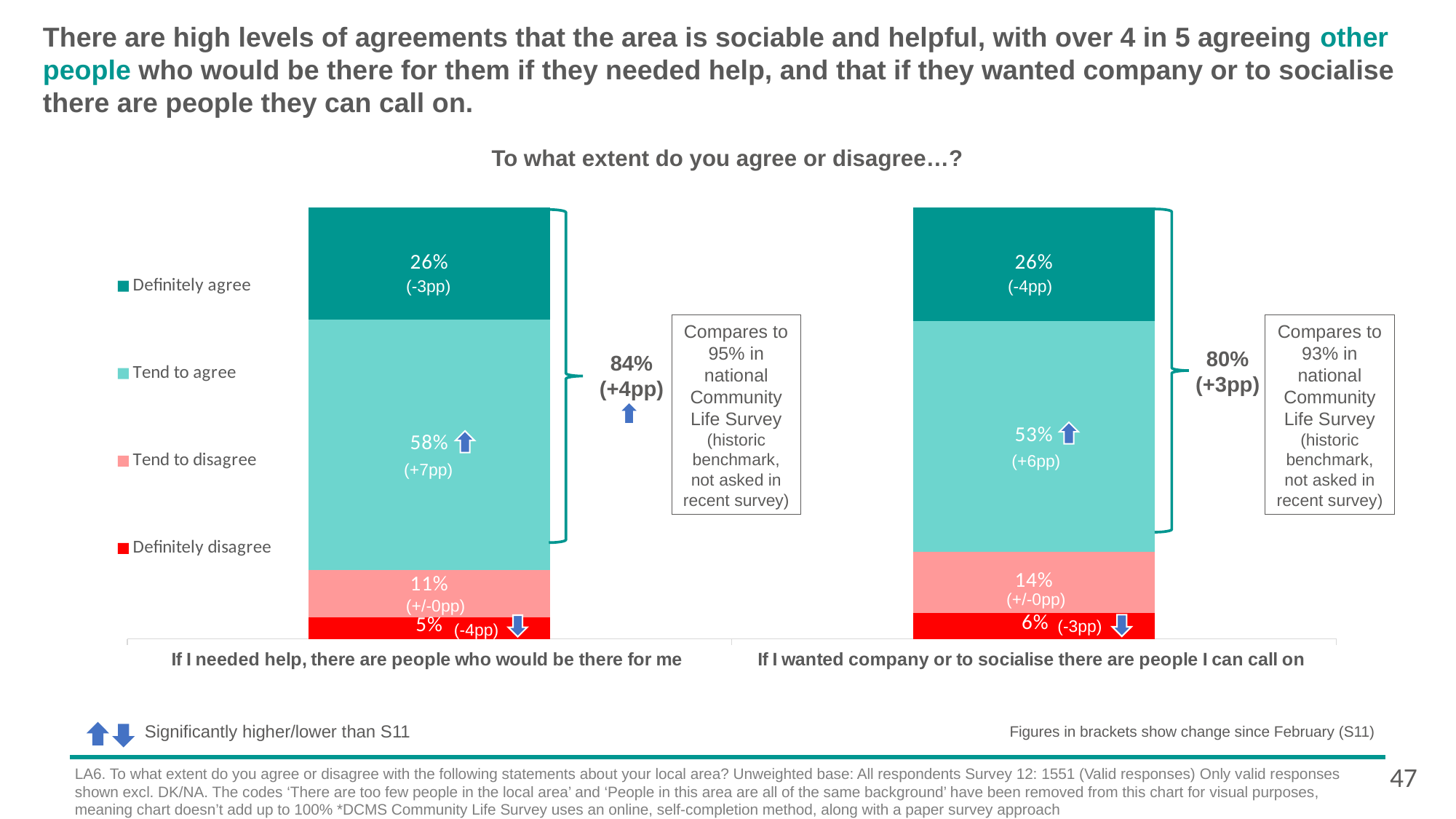
How many response categories does the legend list? 4 How many statements (bars) are shown in the chart? 2 What percentage 'Tend to disagree' that if they wanted company or to socialise there are people they can call on? 14% What percentage 'Definitely agree' that if they wanted company or to socialise there are people they can call on? 26% Which statement has the larger 'Tend to disagree' percentage? If I wanted company or to socialise there are people I can call on What type of chart is shown on the slide? Stacked bar chart What is the combined agreement figure shown for 'If I needed help, there are people who would be there for me'? 84% Which response category is the largest segment in the bar for 'If I needed help, there are people who would be there for me'? Tend to agree What is the combined agreement figure shown for 'If I wanted company or to socialise there are people I can call on'? 80% What percentage 'Definitely disagree' that if they needed help, there are people who would be there for them? 5% What percentage of respondents 'Tend to agree' that if they needed help, there are people who would be there for them? 58% What is the difference between the 'Tend to agree' percentages for the two statements? 5%